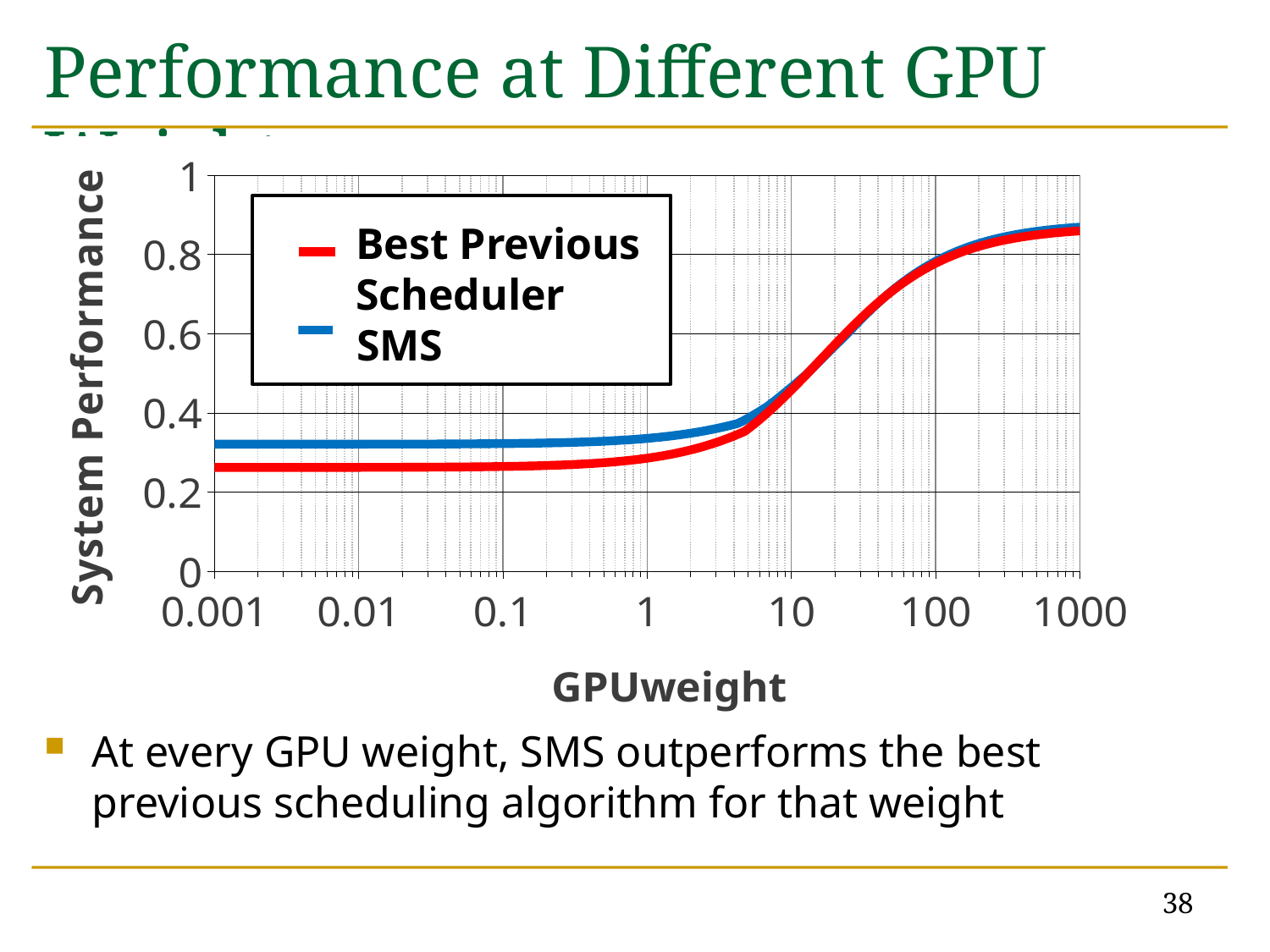
Do the System Performance values rise or fall as GPUweight increases from 0.001 to 1000? rise How many series does the legend list? 2 Which two series are listed in the chart legend? Best Previous Scheduler and SMS Is the System Performance of the Best Previous Scheduler at a GPUweight of 0.001 greater or less than 0.4? less At a GPUweight of 1, which series has the higher System Performance, SMS or Best Previous Scheduler? SMS Is the System Performance of the Best Previous Scheduler at a GPUweight of 1 greater or less than 0.4? less What kind of chart is shown on the slide? line chart At a GPUweight of 0.001, which series has the higher System Performance, SMS or Best Previous Scheduler? SMS Is the System Performance of SMS at a GPUweight of 10 greater or less than 0.4? greater What is the label of the x axis? GPUweight